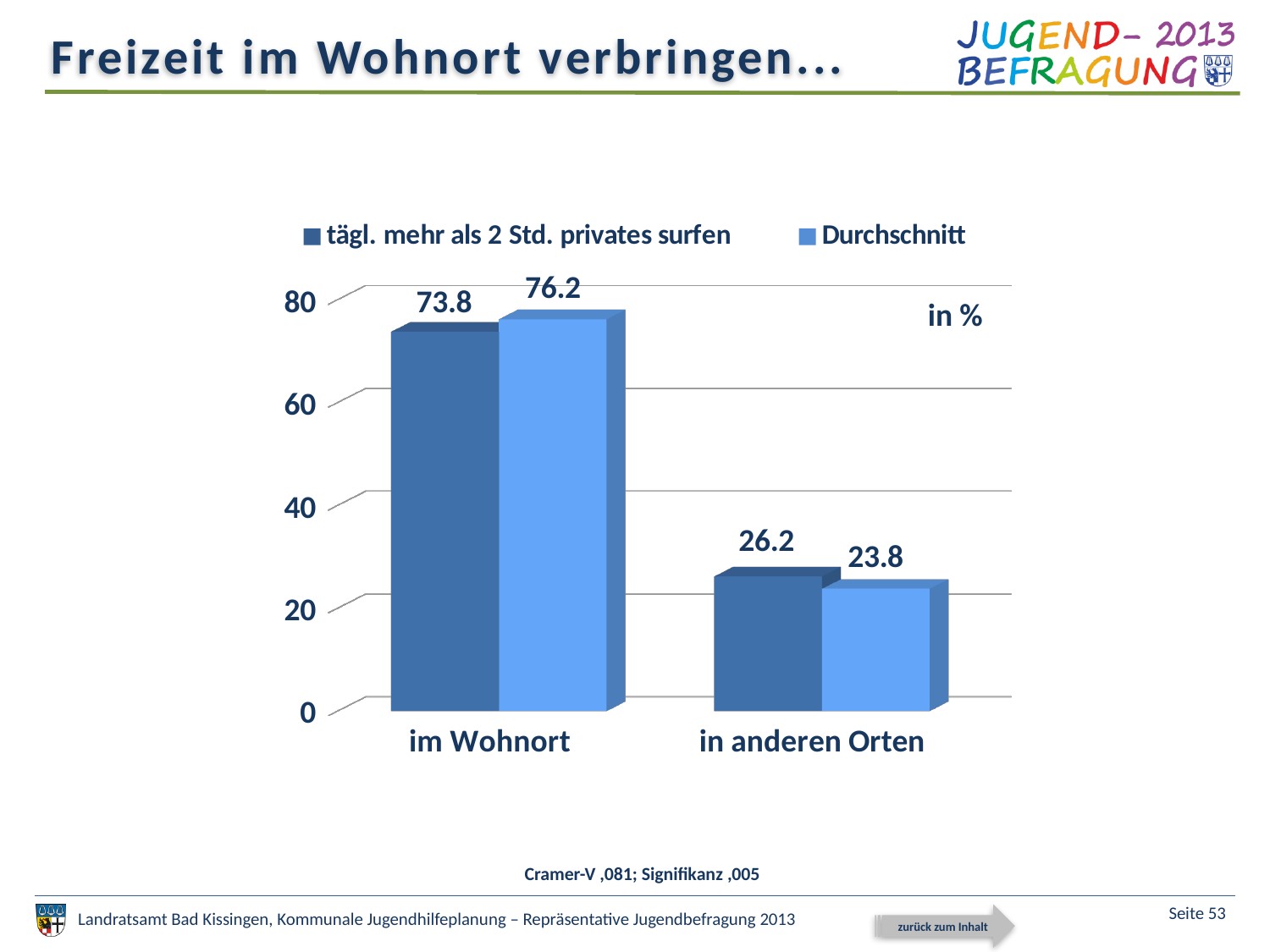
What is the value for "tägl. mehr als 2 Std. privates surfen" in the "in anderen Orten" category? 26.2 What kind of chart is shown on the slide? bar chart How many series does the legend list? 2 Which category has the lowest value for the "tägl. mehr als 2 Std. privates surfen" series? in anderen Orten What is the value for "Durchschnitt" in the "im Wohnort" category? 76.2 What is the value for "tägl. mehr als 2 Std. privates surfen" in the "im Wohnort" category? 73.8 What is the difference between the "Durchschnitt" and "tägl. mehr als 2 Std. privates surfen" values in the "im Wohnort" category? 2.4 Which category has the highest value for the "Durchschnitt" series? im Wohnort How many categories are shown on the x axis? 2 In the "in anderen Orten" category, which series has the larger value? tägl. mehr als 2 Std. privates surfen What is the value for "Durchschnitt" in the "in anderen Orten" category? 23.8 What unit is indicated for the values in the chart? %